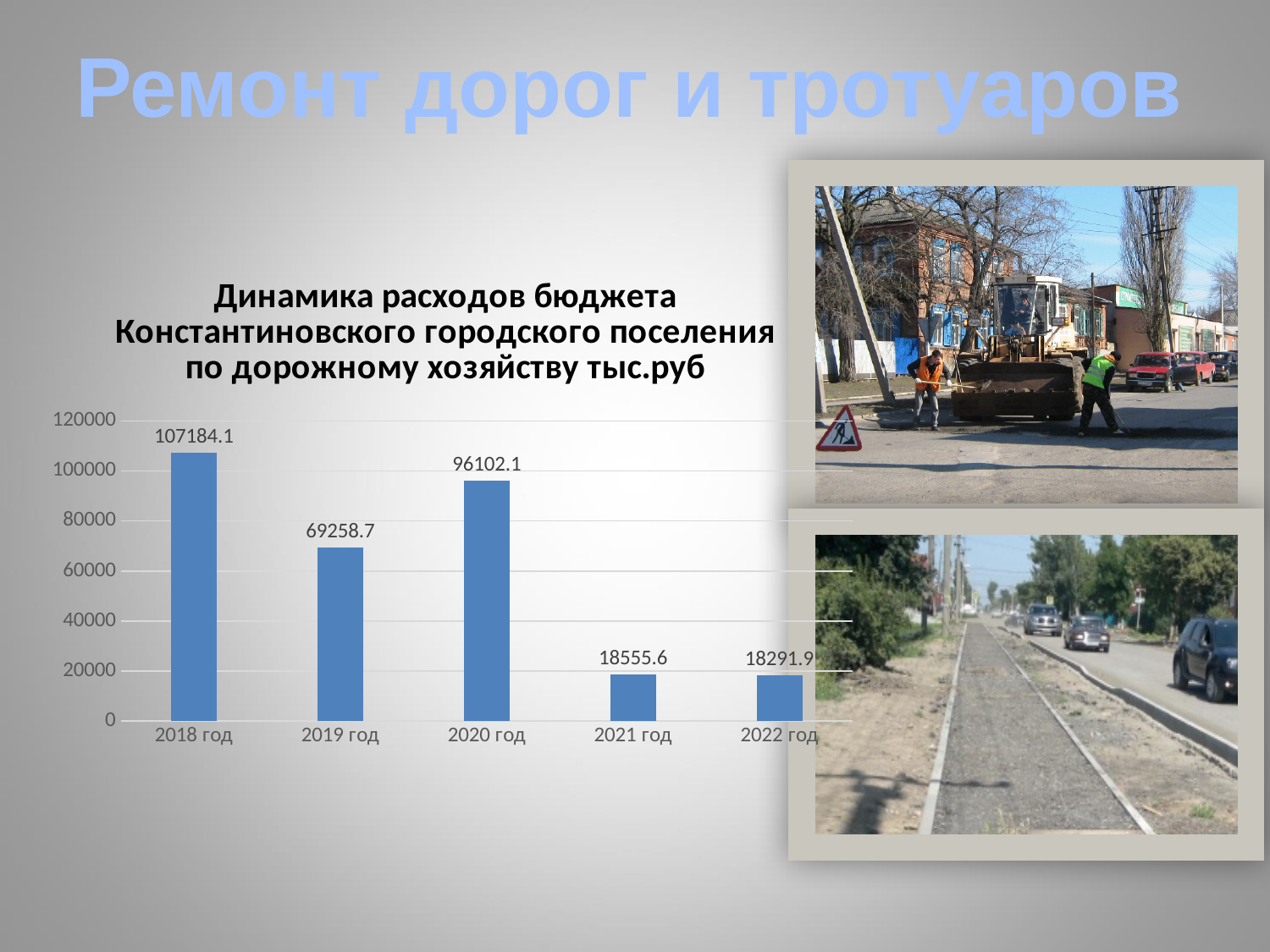
What kind of chart is shown on the slide? bar chart What is the value for 2018 год in the chart? 107184.1 What unit is stated in the chart title? тыс.руб What is the value for 2021 год in the chart? 18555.6 How many years are shown on the x axis of the chart? 5 Which year has the lowest value in the chart? 2022 год Is the value for 2019 год greater or less than 60000? greater Which year has the highest value in the chart? 2018 год Which is larger, the value for 2019 год or the value for 2020 год? 2020 год What is the difference between the values for 2018 год and 2019 год? 37925.4 What is the difference between the values for 2020 год and 2021 год? 77546.5 What is the value for 2022 год in the chart? 18291.9